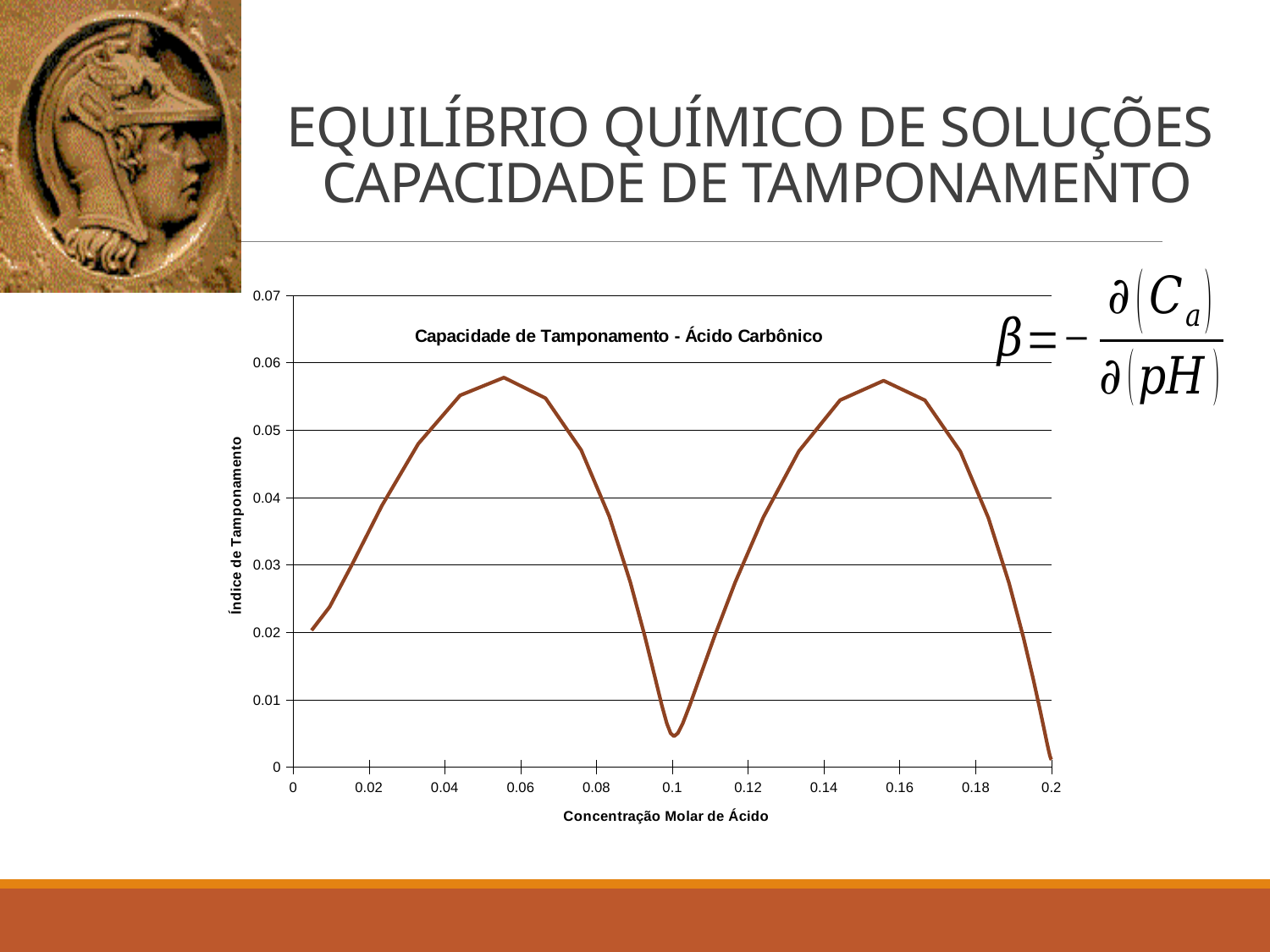
What is the title of the chart? Capacidade de Tamponamento - Ácido Carbônico Is the value at a concentration of 0.2 greater or less than 0.01? less Is the value at a concentration of 0.06 greater or less than 0.05? greater What kind of chart is shown on the slide? line chart Is the value at a concentration of 0.02 greater or less than 0.03? greater Do the values rise or fall as the concentration goes from 0.1 to 0.16? rise Do the values rise or fall as the concentration goes from 0.16 to 0.2? fall Which has the larger value: a concentration of 0.06 or a concentration of 0.1? 0.06 What is the label of the x axis of the chart? Concentração Molar de Ácido